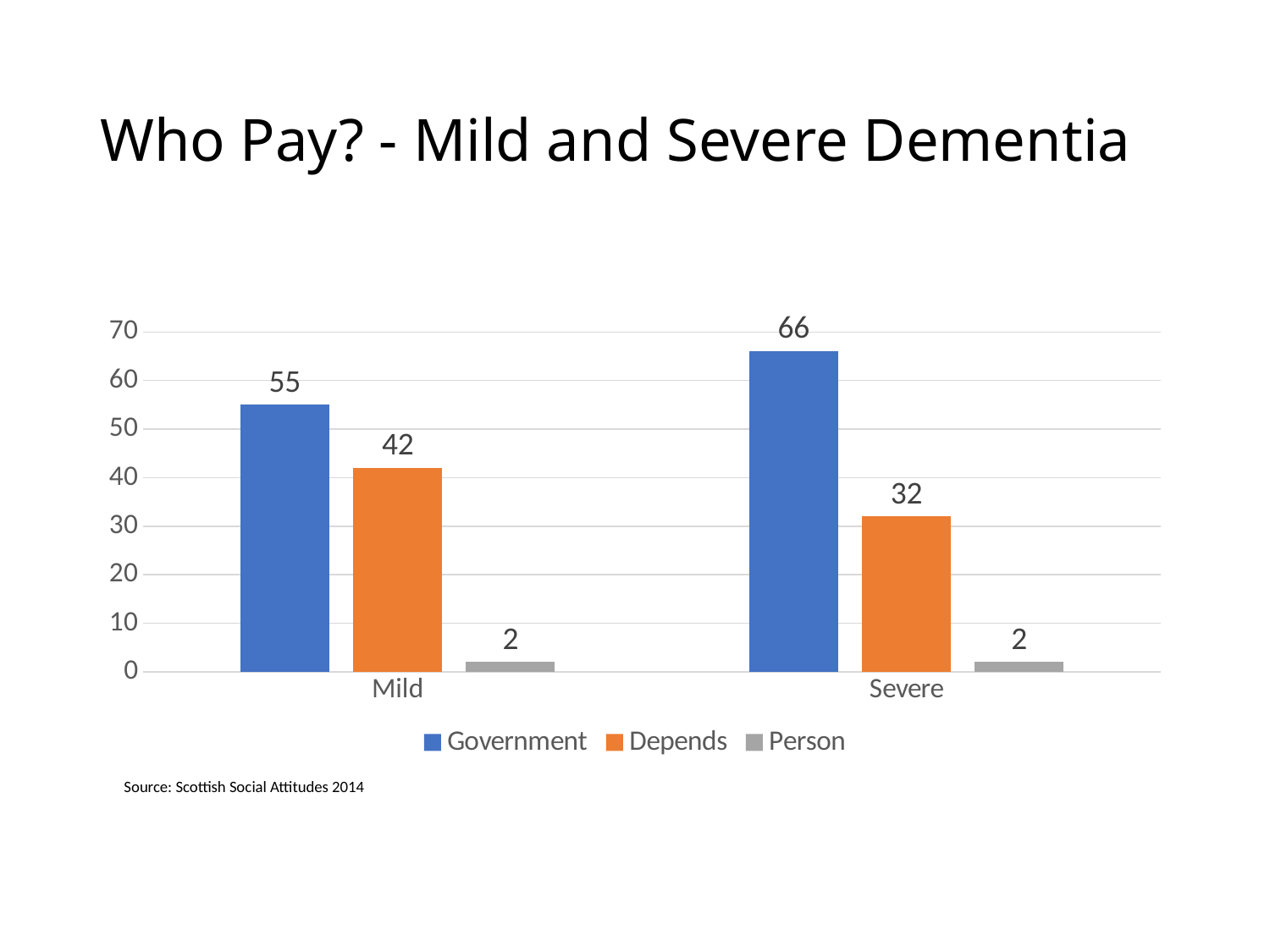
What kind of chart is shown on the slide? Bar chart What is the value for Government in the Mild category? 55 What is the difference between Government and Depends in the Mild category? 13 Which series has the highest value in the Severe category? Government How many series does the legend list? 3 Which is larger, Depends for Mild or Depends for Severe? Depends for Mild Which series has the lowest value in the Mild category? Person What is the value for Depends in the Severe category? 32 How many categories are shown on the x axis? 2 What is the value for Person in the Mild category? 2 What is the source cited below the chart? Scottish Social Attitudes 2014 What is the difference between the Government values for Severe and Mild? 11